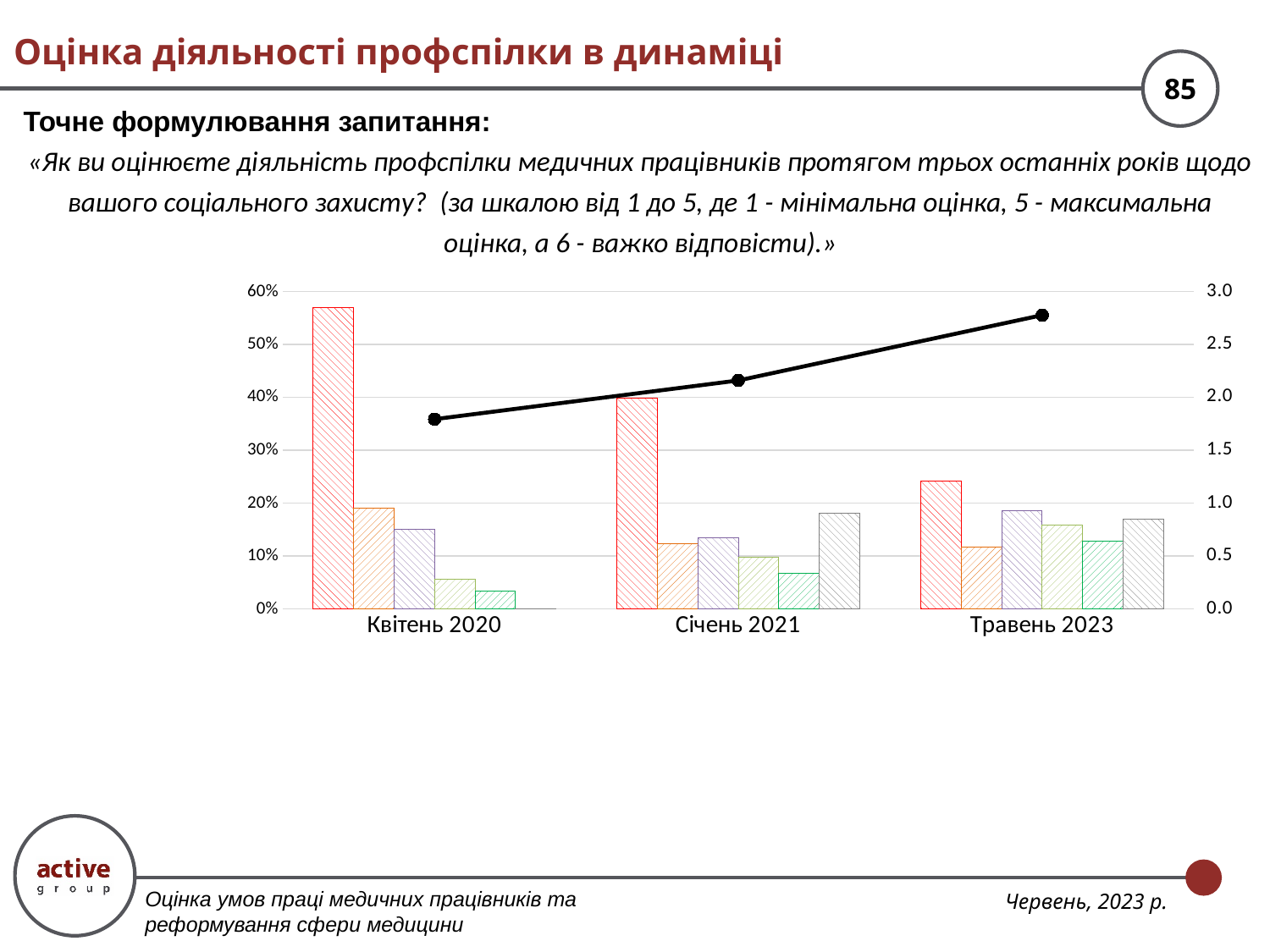
What is the maximum value shown on the left vertical axis of the chart? 60% Is the line value for Квітень 2020 greater or less than 2.0 on the right axis? less Is the tallest bar for Травень 2023 greater or less than 30%? less Is the tallest bar for Січень 2021 greater or less than 30%? greater Which category contains the tallest bar in the chart? Квітень 2020 Which category has the highest value on the line series? Травень 2023 Does the line series rise or fall from Квітень 2020 to Травень 2023? Rises How many categories are shown on the x axis of the chart? 3 Which is larger: the tallest bar for Квітень 2020 or the tallest bar for Січень 2021? Квітень 2020 What kind of chart is shown on the slide? Bar chart combined with a line